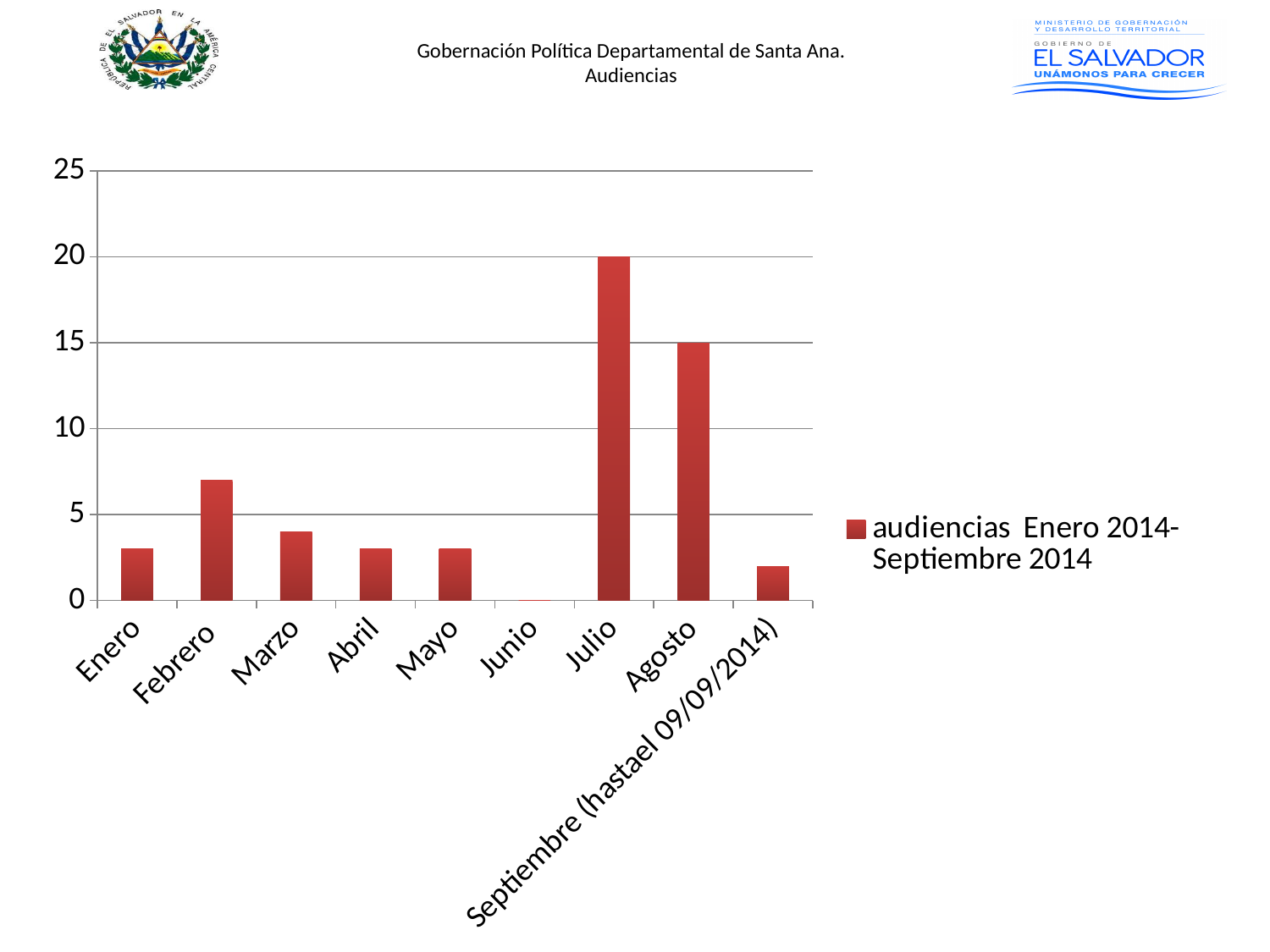
Which month has the highest number of audiencias? Julio What is the value for Junio? 0 What is the difference between the values for Julio and Agosto? 5 Which month has the lowest number of audiencias? Junio Is the value for Enero greater or less than 5? less Is the value for Febrero greater or less than 5? greater How many months (categories) are shown on the x axis? 9 Which is larger, the value for Febrero or the value for Marzo? Febrero What is the value for Julio? 20 How many series does the legend list? 1 What is the value for Agosto? 15 What type of chart is shown on the slide? bar chart